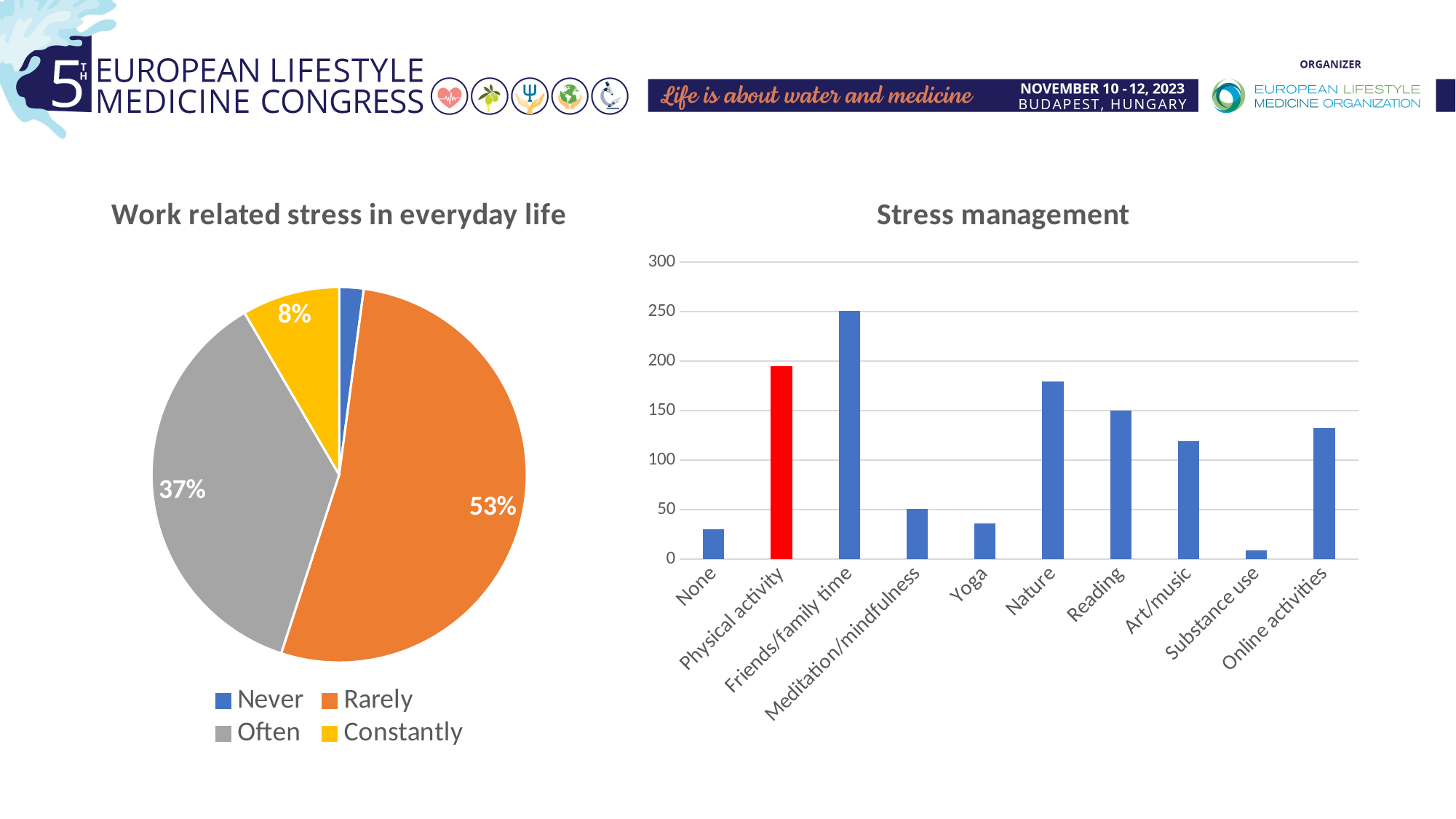
In the 'Work related stress in everyday life' pie chart, what share is labelled for Rarely? 53% What kind of chart is 'Stress management'? Bar chart In the 'Stress management' chart, which category has the lowest bar? Substance use In the 'Stress management' chart, is the value for Physical activity greater or less than 150? greater In the 'Work related stress in everyday life' pie chart, what share is labelled for Constantly? 8% In the 'Stress management' chart, which category has the highest bar? Friends/family time In the 'Work related stress in everyday life' pie chart, which category has the largest slice? Rarely How many categories does the legend of the 'Work related stress in everyday life' chart list? 4 In the 'Stress management' chart, how many categories are shown on the x axis? 10 In the 'Work related stress in everyday life' pie chart, what share is labelled for Often? 37% In the 'Work related stress in everyday life' pie chart, how many percentage points larger is Rarely than Often? 16 In the 'Stress management' chart, which category's bar is coloured red? Physical activity